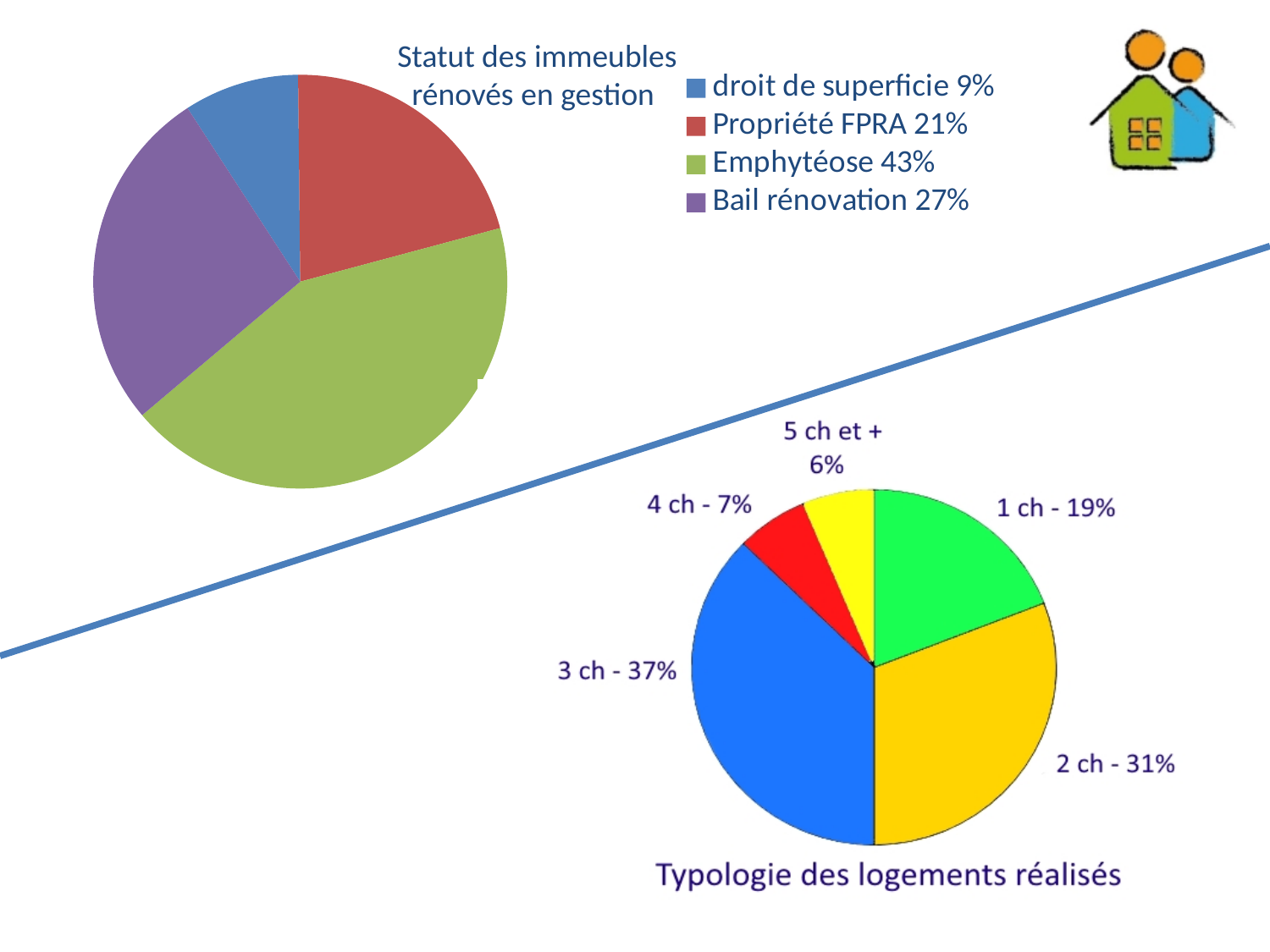
In the 'Statut des immeubles rénovés en gestion' chart, which category has the largest share? Emphytéose In the 'Statut des immeubles rénovés en gestion' chart, what is the difference between Bail rénovation and Propriété FPRA? 6% In the 'Typologie des logements réalisés' chart, what is the difference between 3 ch and 2 ch? 6% In the 'Statut des immeubles rénovés en gestion' chart, what share does Emphytéose have? 43% How many slices does the 'Typologie des logements réalisés' pie chart have? 5 In the 'Statut des immeubles rénovés en gestion' chart, what share does droit de superficie have? 9% In the 'Typologie des logements réalisés' chart, what share do 3 ch dwellings have? 37% What type of chart is 'Statut des immeubles rénovés en gestion'? Pie chart In the 'Statut des immeubles rénovés en gestion' chart, how many categories does the legend list? 4 In the 'Typologie des logements réalisés' chart, which is larger: 1 ch or 2 ch? 2 ch In the 'Typologie des logements réalisés' chart, which category has the smallest share? 5 ch et + In the 'Statut des immeubles rénovés en gestion' chart, which category has the smallest share? droit de superficie